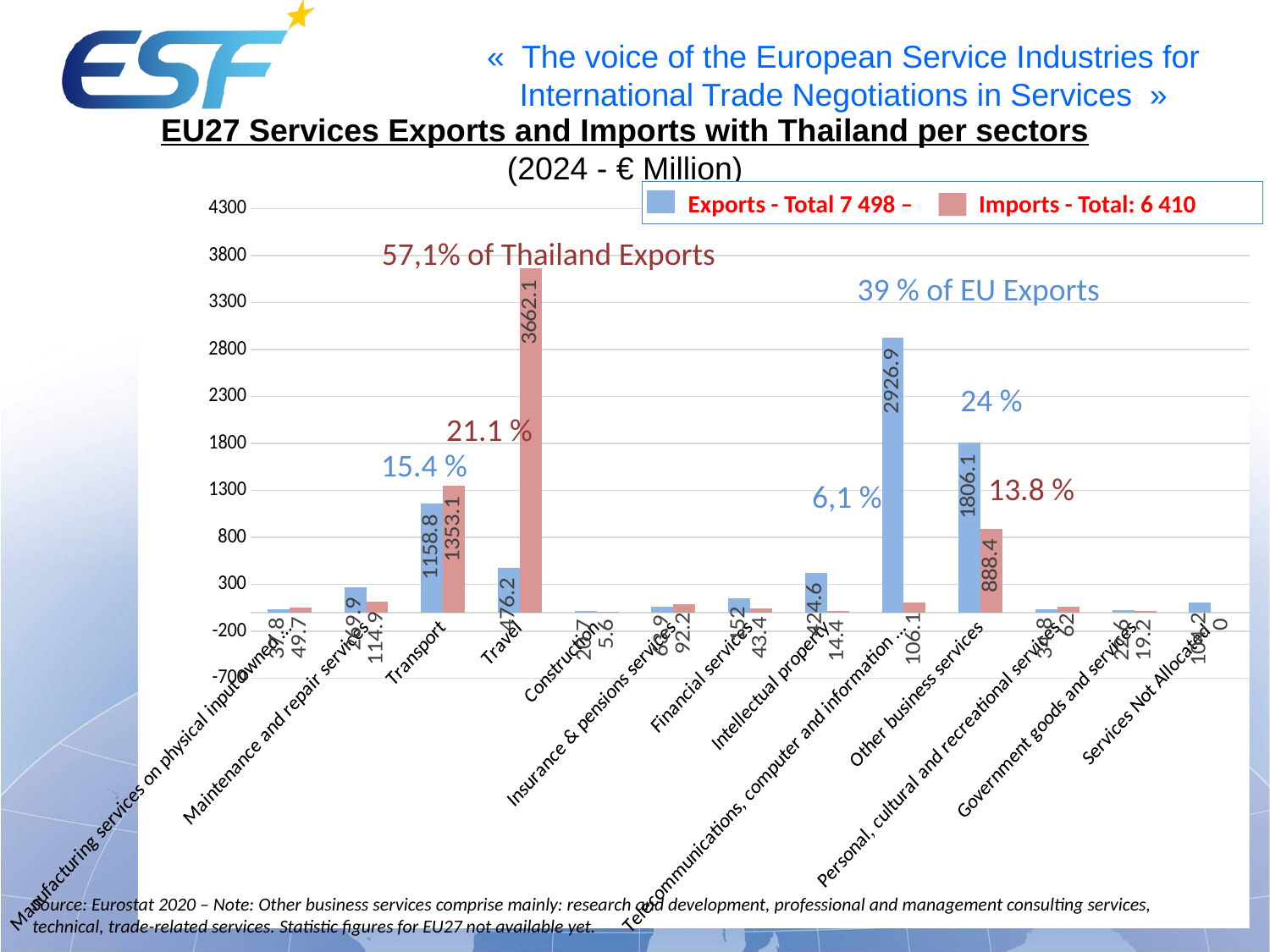
Which sector has the highest Exports value? Telecommunications, computer and information What is the difference between Imports and Exports for Transport? 194.3 How many series does the legend list? 2 What is the value of Exports for Transport? 1158.8 How many sector categories are plotted along the x axis? 13 What is the value of Imports for Travel? 3662.1 What is the value of Imports for Other business services? 888.4 According to the legend, what is the total of Exports? 7 498 What kind of chart is shown on the slide? bar chart For Other business services, which is larger, Exports or Imports? Exports Which sector has the highest Imports value? Travel What is the value of Exports for Telecommunications, computer and information services? 2926.9